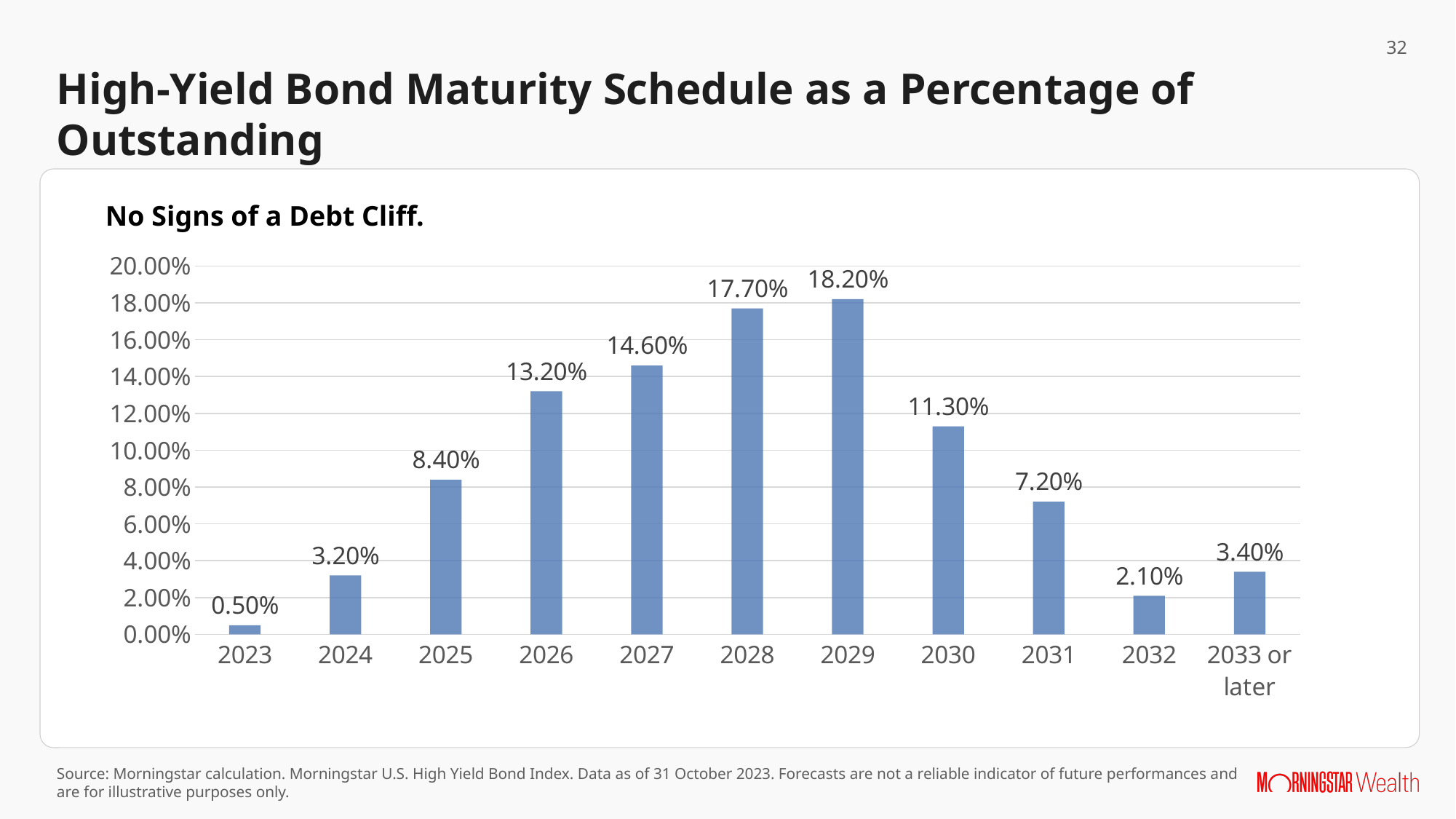
What is the difference between the values for 2027 and 2025? 6.20% Which year has the lowest value? 2023 Is the value for 2028 greater or less than 16.00%? greater How many categories are shown on the x axis? 11 What is the value for 2031? 7.20% What is the difference between the values for 2029 and 2028? 0.50% Which year has the highest value? 2029 Which is larger, the value for 2030 or the value for 2026? 2026 What is the value for 2026? 13.20% What is the value for 2033 or later? 3.40% What kind of chart is shown on the slide? Bar chart Do the values rise or fall from 2023 to 2029? Rise